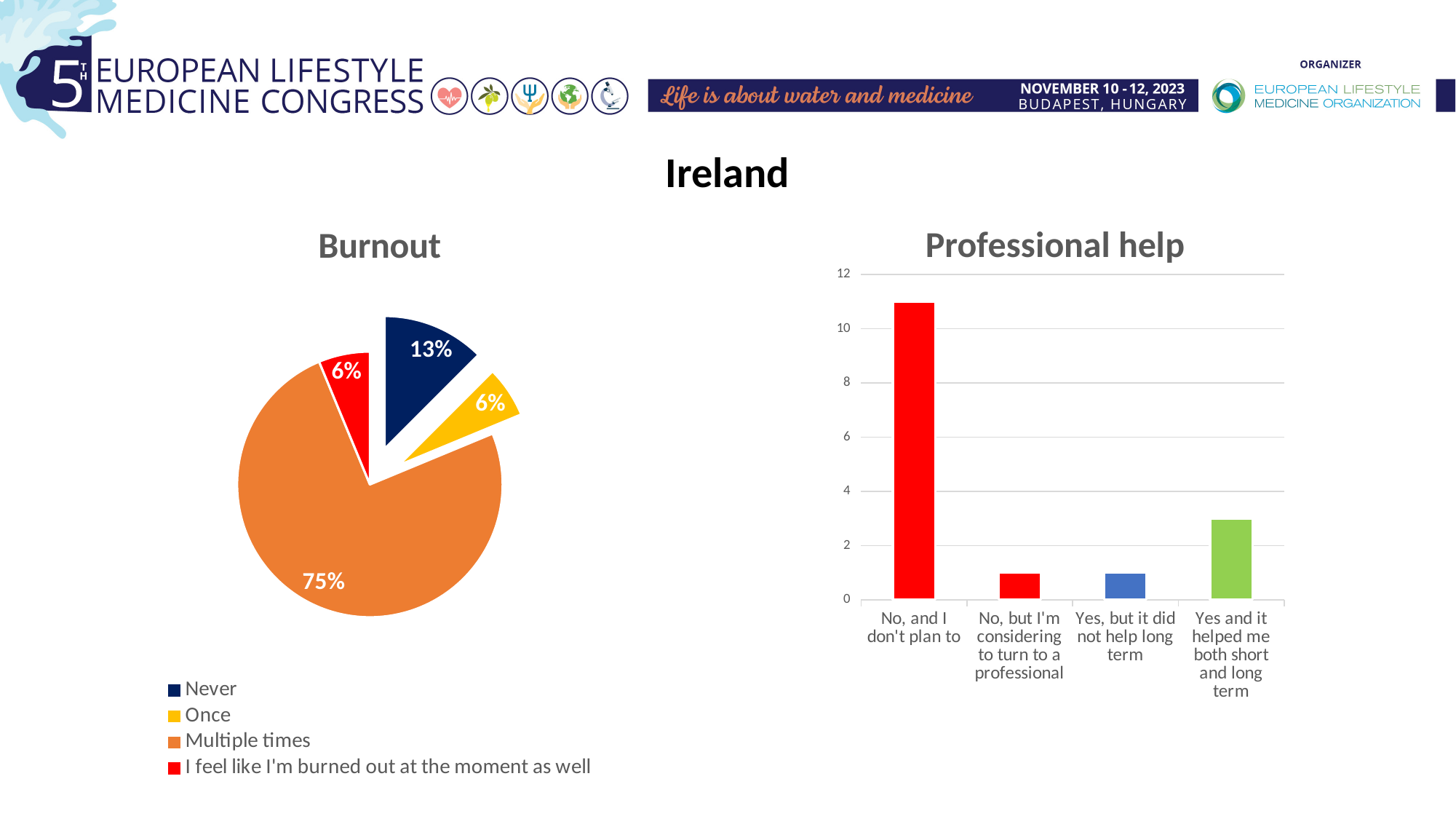
In the Burnout pie chart, what percentage is shown for 'Multiple times'? 75% In the Burnout pie chart, what percentage is shown for 'Once'? 6% In the Burnout pie chart, which category has the largest share? Multiple times In the Burnout pie chart, which colour represents 'I feel like I'm burned out at the moment as well'? Red In the Burnout pie chart, how many categories does the legend list? 4 In the Burnout pie chart, what is the difference between the 'Multiple times' share and the 'Never' share? 62% What type of chart is the Professional help chart? Bar chart What type of chart is the Burnout chart? Pie chart In the Professional help chart, which category has the highest value? No, and I don't plan to In the Professional help chart, is the value for 'No, and I don't plan to' greater or less than 10? greater In the Burnout pie chart, what percentage is shown for 'Never'? 13% In the Professional help chart, is the value for 'Yes and it helped me both short and long term' greater or less than 4? less